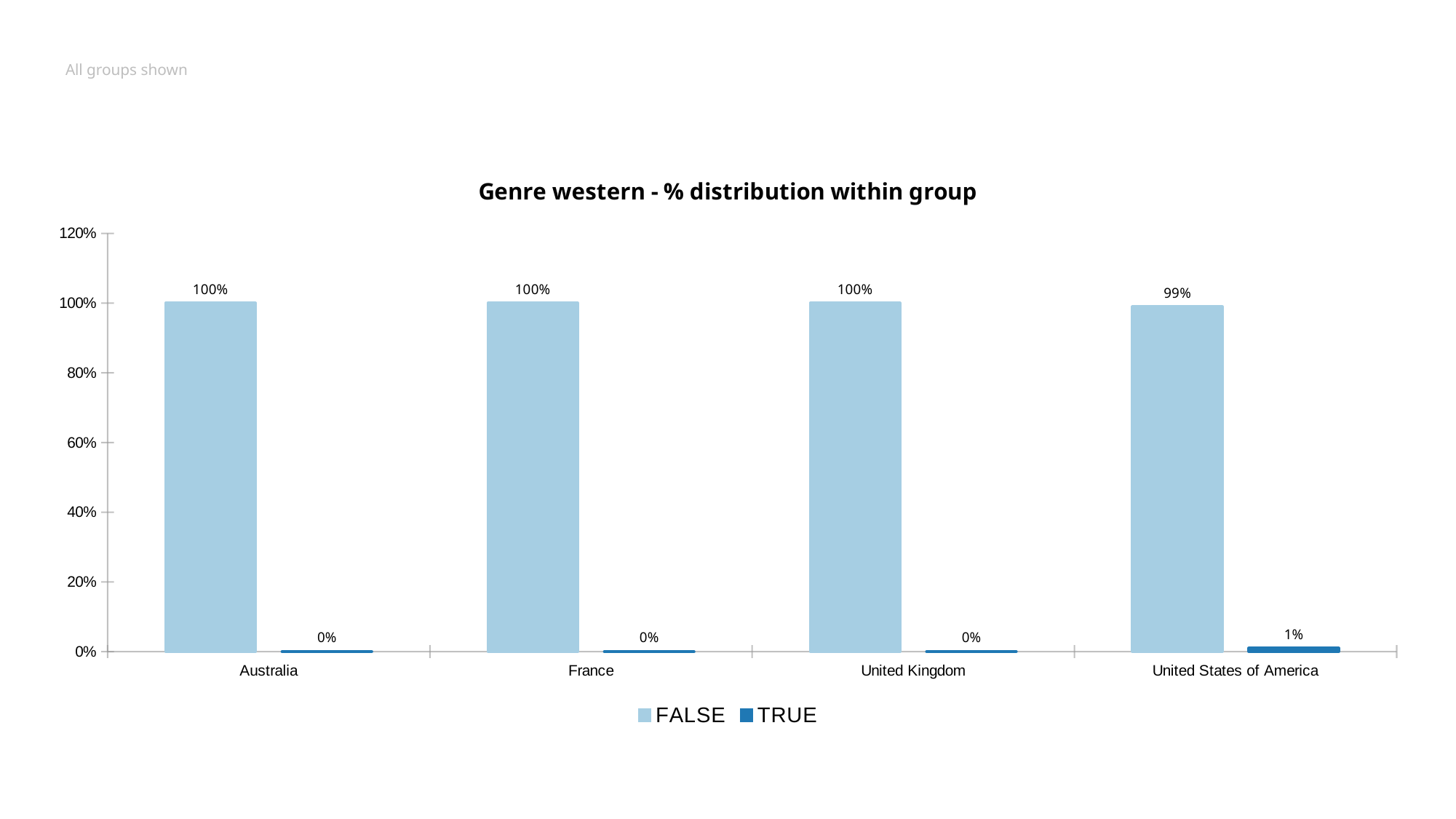
What is the difference between the FALSE and TRUE values for United States of America? 98% What is the FALSE value for United States of America? 99% What is the TRUE value for France? 0% How many categories are shown on the x axis? 4 What is the FALSE value for Australia? 100% Is the FALSE value for France greater or less than 80%? greater Which category has the highest TRUE value? United States of America How many series does the legend list? 2 What is the TRUE value for United States of America? 1% Which is larger for United Kingdom, the FALSE value or the TRUE value? FALSE What kind of chart is shown? bar chart Which category has the lowest FALSE value? United States of America